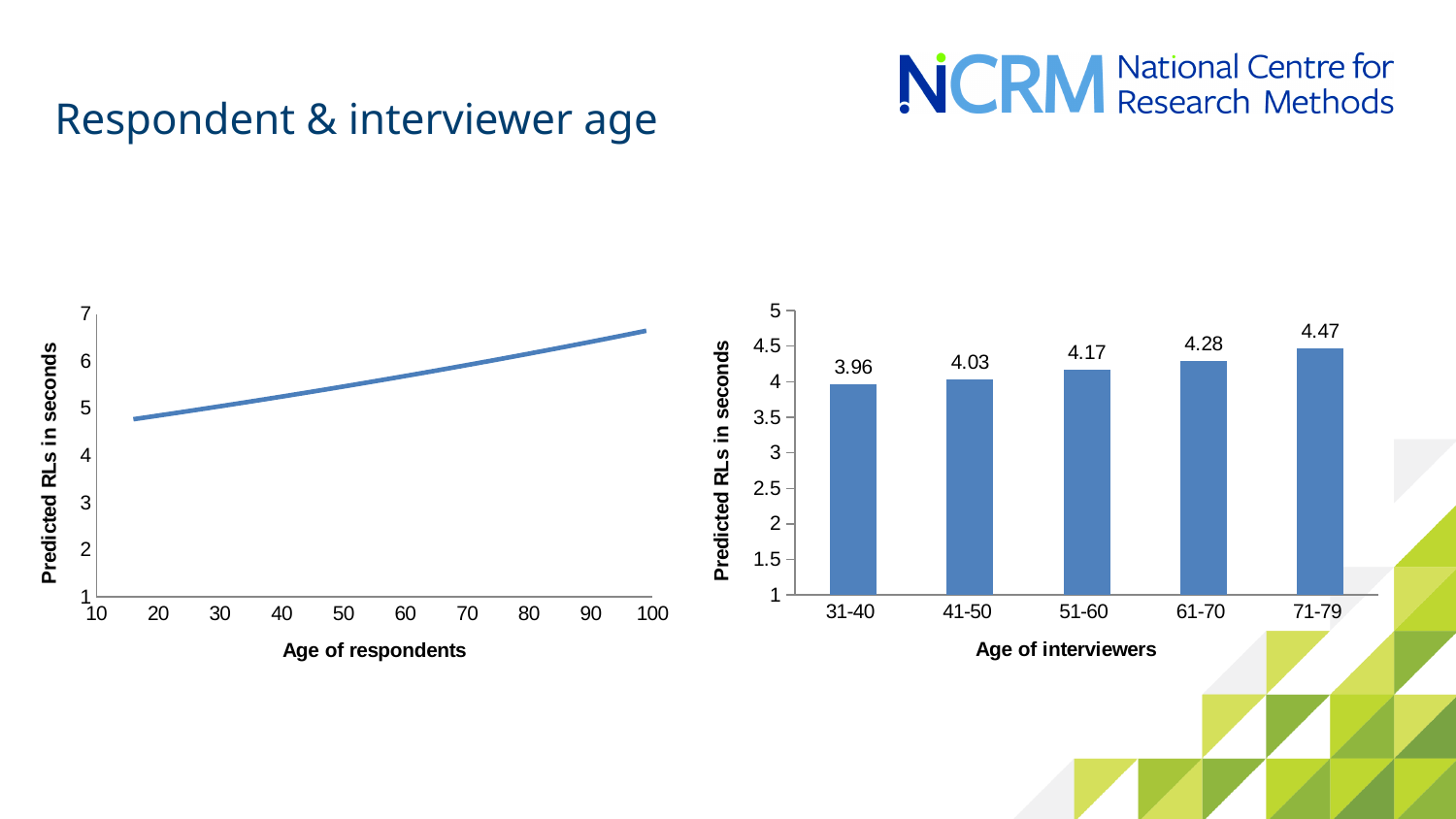
In the left-hand chart (Age of respondents), do the predicted RLs rise or fall as respondent age increases? rise What kind of chart is the left-hand chart (Age of respondents)? line chart In the right-hand chart (Age of interviewers), which interviewer age group has the lowest predicted RLs? 31-40 In the right-hand chart (Age of interviewers), how many interviewer age groups are shown? 5 In the right-hand chart (Age of interviewers), what is the difference between the values for the 71-79 and 31-40 age groups? 0.51 In the right-hand chart (Age of interviewers), what is the predicted RLs in seconds for interviewers aged 31-40? 3.96 In the left-hand chart (Age of respondents), is the predicted RLs value at age 90 greater or less than 5? greater In the right-hand chart (Age of interviewers), what is the value for the 51-60 age group? 4.17 In the right-hand chart (Age of interviewers), do the predicted RLs rise or fall as interviewer age increases? rise In the right-hand chart (Age of interviewers), what is the value for the 71-79 age group? 4.47 In the right-hand chart (Age of interviewers), which interviewer age group has the highest predicted RLs? 71-79 In the right-hand chart (Age of interviewers), what is the difference between the values for the 61-70 and 41-50 age groups? 0.25